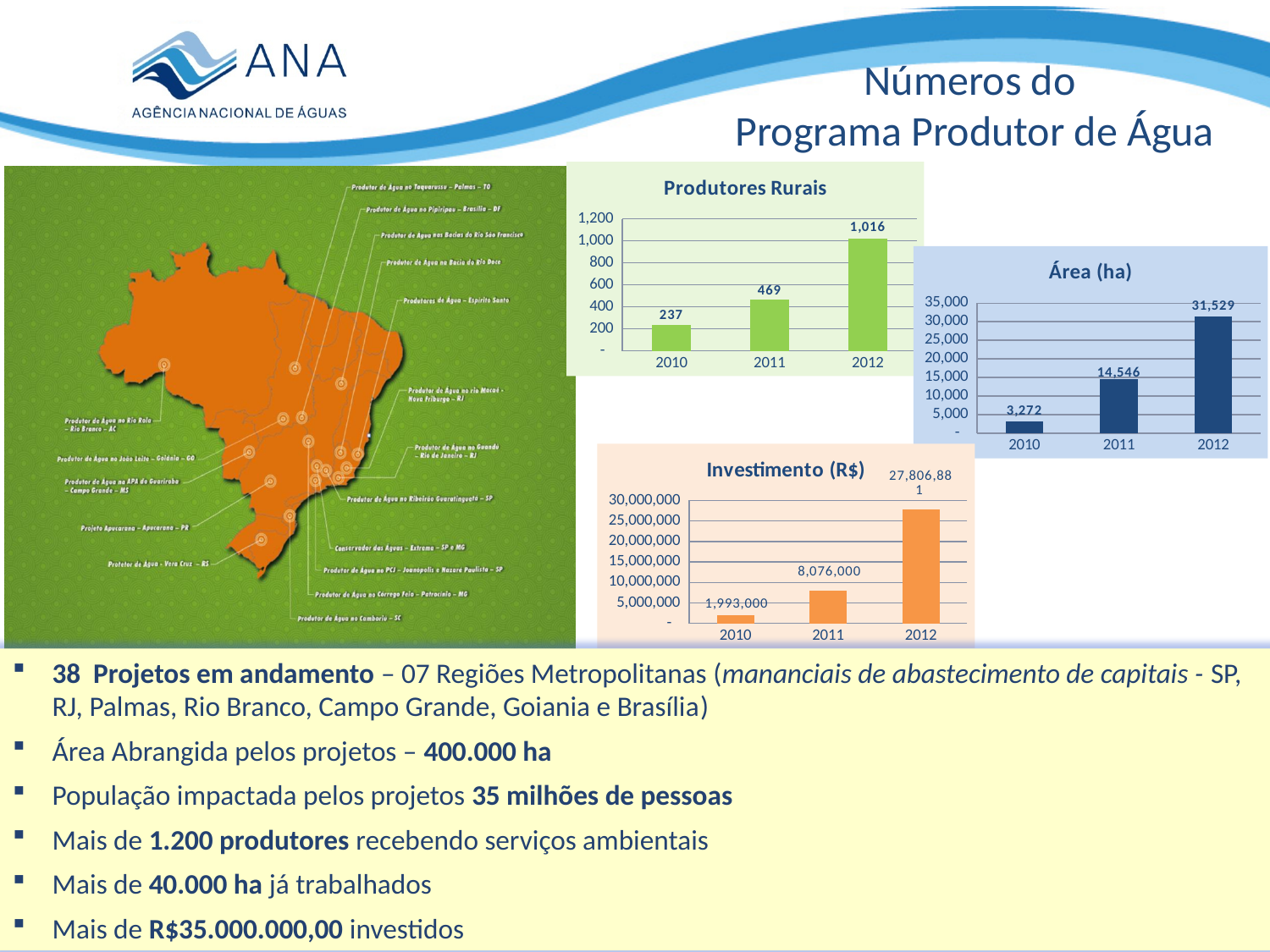
What kind of chart is the 'Área (ha)' chart? bar chart In the 'Investimento (R$)' chart, which year has the lowest value? 2010 In the 'Produtores Rurais' chart, what is the value for 2010? 237 In the 'Investimento (R$)' chart, what is the value for 2011? 8,076,000 In the 'Produtores Rurais' chart, what is the value for 2012? 1,016 In the 'Área (ha)' chart, is the value for 2010 greater or less than 5,000? less In the 'Produtores Rurais' chart, what is the difference between the 2011 and 2010 values? 232 In the 'Área (ha)' chart, what is the value for 2011? 14,546 In the 'Área (ha)' chart, which year has the highest value? 2012 How many years are shown on the x axis of the 'Produtores Rurais' chart? 3 In the 'Investimento (R$)' chart, is the value for 2012 greater or less than 25,000,000? greater In the 'Investimento (R$)' chart, do the values rise or fall from 2010 to 2012? rise